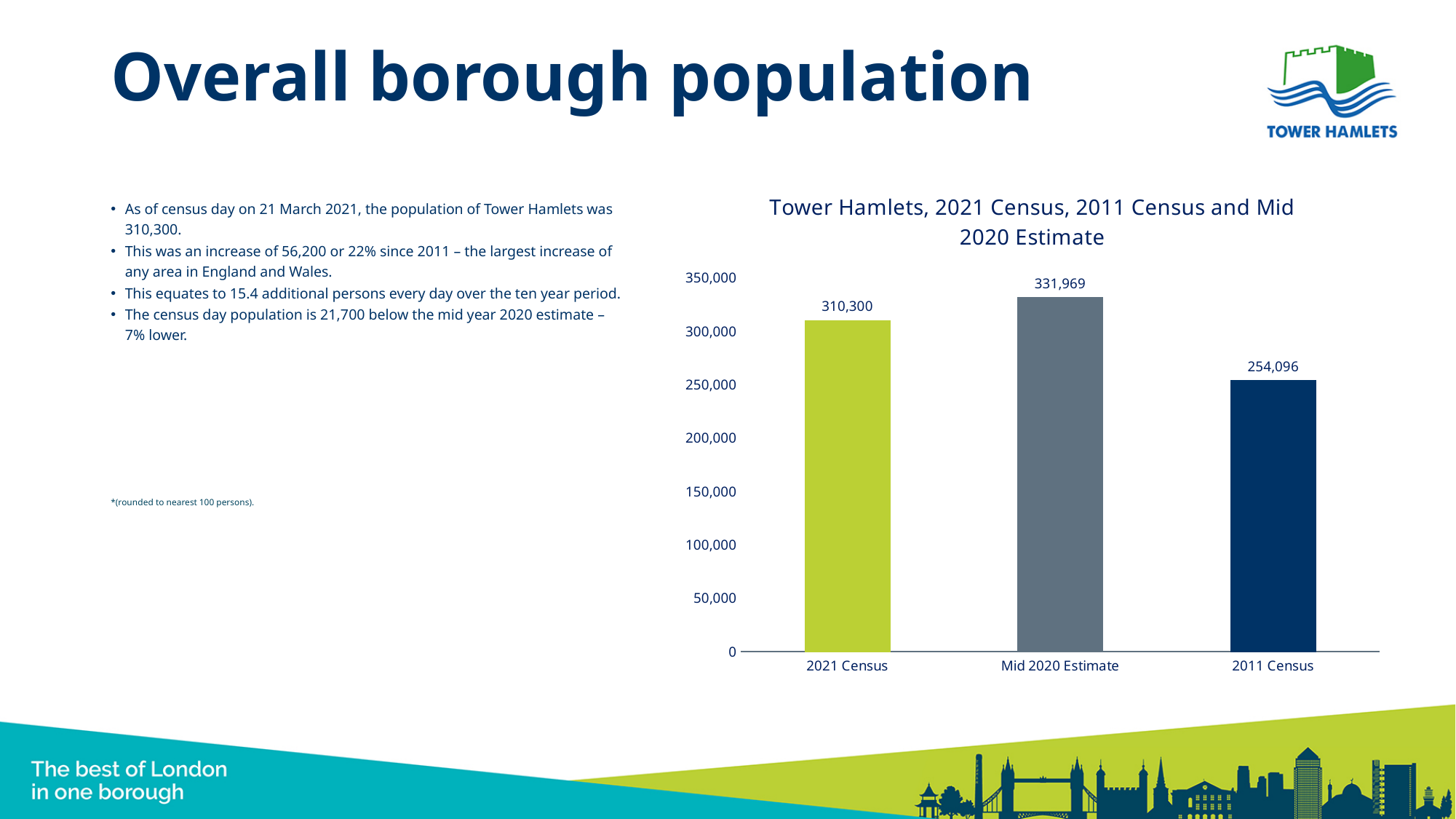
What kind of chart is shown on the slide? bar chart What is the difference between the Mid 2020 Estimate and the 2021 Census values? 21,669 How many categories are shown on the chart? 3 What is the value for 2011 Census? 254,096 What is the title of the chart? Tower Hamlets, 2021 Census, 2011 Census and Mid 2020 Estimate Which is larger, the 2021 Census value or the 2011 Census value? 2021 Census Which category has the highest value? Mid 2020 Estimate Is the value for 2011 Census greater or less than 300,000? less What is the value for Mid 2020 Estimate? 331,969 What is the value for 2021 Census? 310,300 What is the difference between the 2021 Census and 2011 Census values? 56,204 Which category has the lowest value? 2011 Census